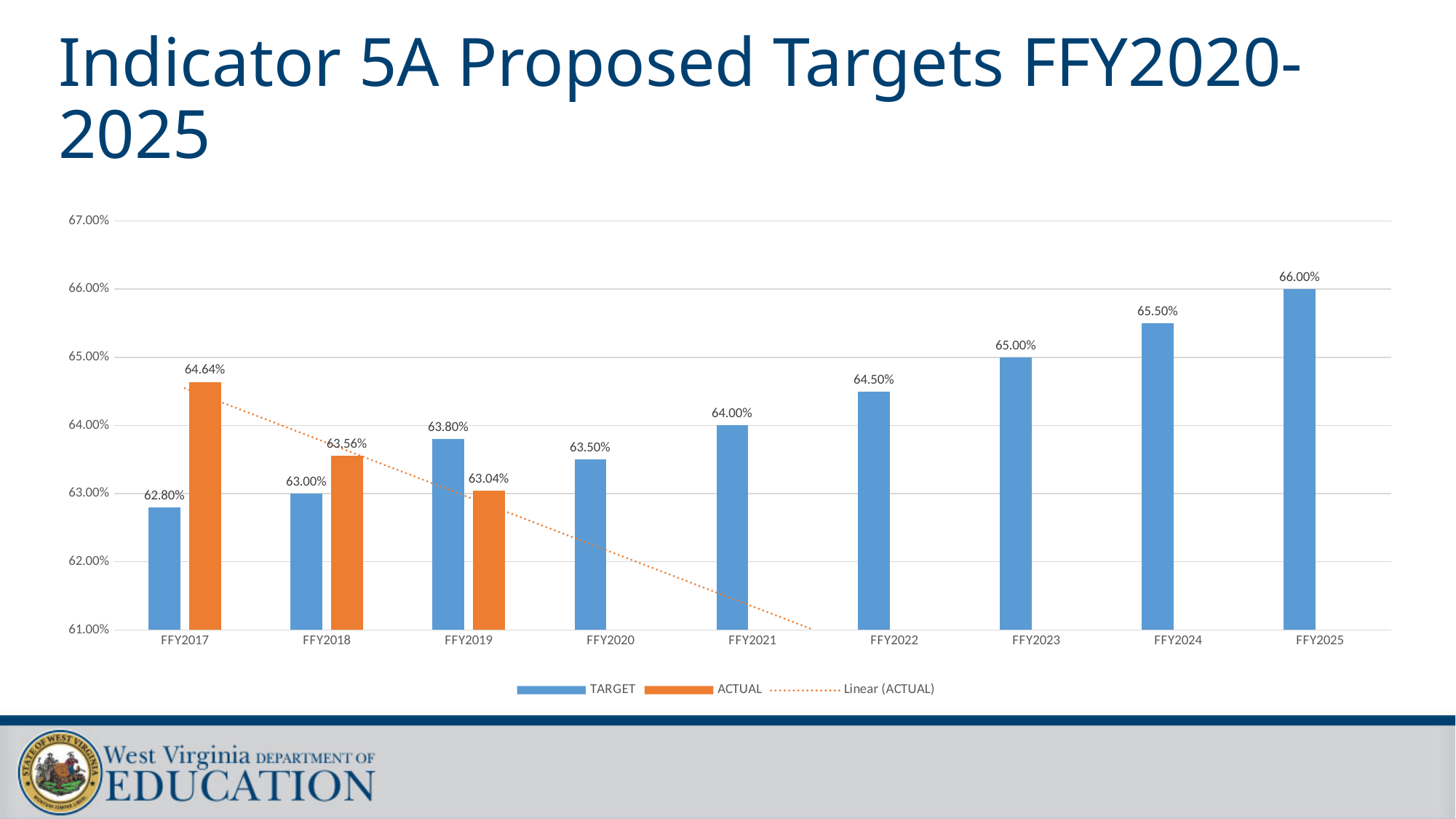
How many entries does the legend list? 3 What is the difference between the ACTUAL and TARGET values for FFY2017? 1.84% What kind of chart is shown on the slide? Bar chart What is the TARGET value for FFY2020? 63.50% Which year has the lowest TARGET value? FFY2017 Do the TARGET values rise or fall from FFY2017 to FFY2025? Rise What is the ACTUAL value for FFY2018? 63.56% Which year has the highest ACTUAL value? FFY2017 What colour are the ACTUAL bars? Orange How many years are shown on the x axis? 9 Which is larger for FFY2019, the TARGET or the ACTUAL value? TARGET What is the TARGET value for FFY2025? 66.00%